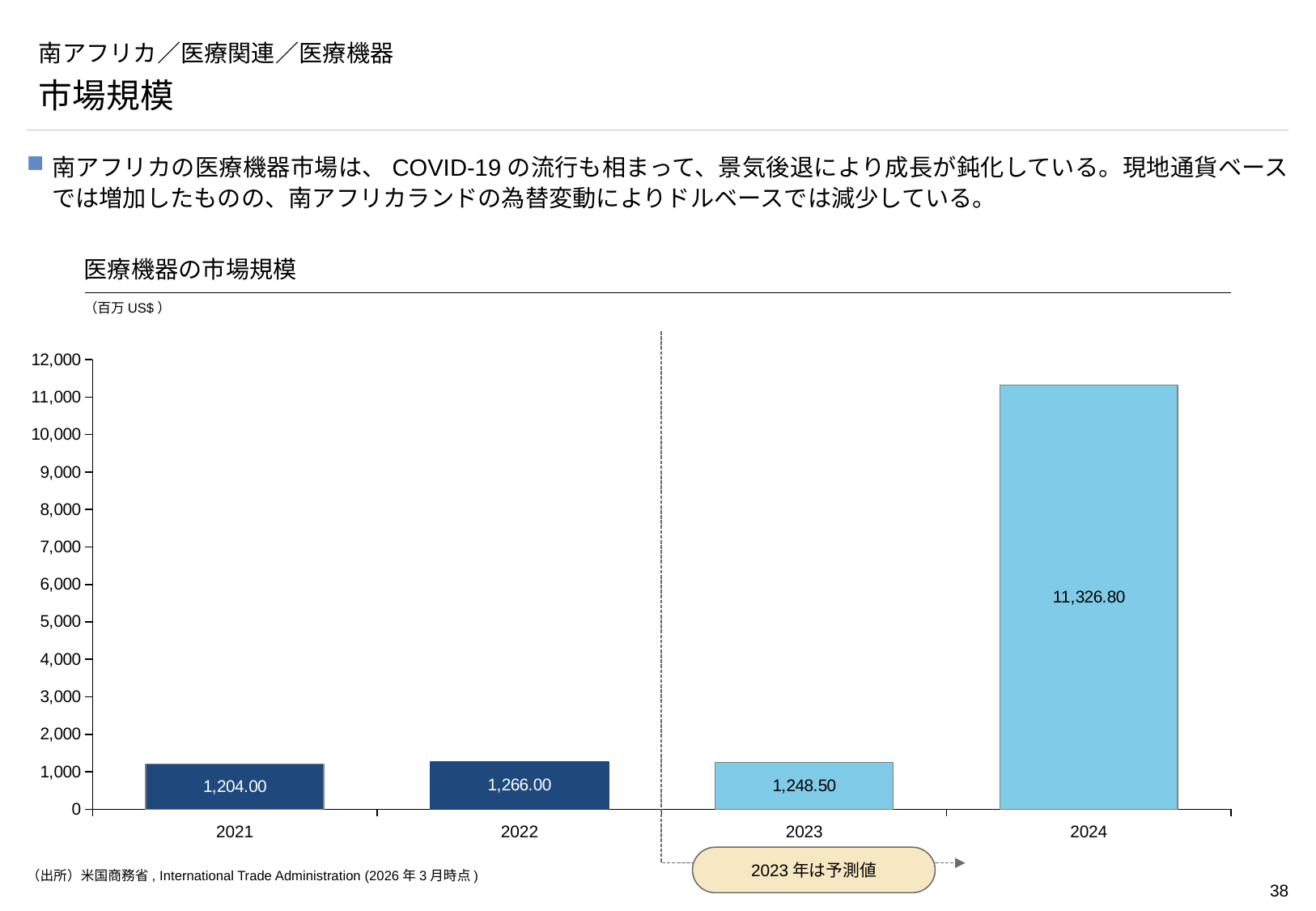
What is the value for 2021? 1,204.00 What is the difference between the values for 2022 and 2021? 62.00 How many years are shown on the x axis? 4 What kind of chart is shown? bar chart What is the value for 2024? 11,326.80 What is the value for 2022? 1,266.00 Which is larger, the value for 2022 or the value for 2023? 2022 What is the value for 2023? 1,248.50 Which year has the highest value? 2024 What is the title of the chart? 医療機器の市場規模 Is the value for 2024 greater or less than 10,000? greater Which year has the lowest value? 2021